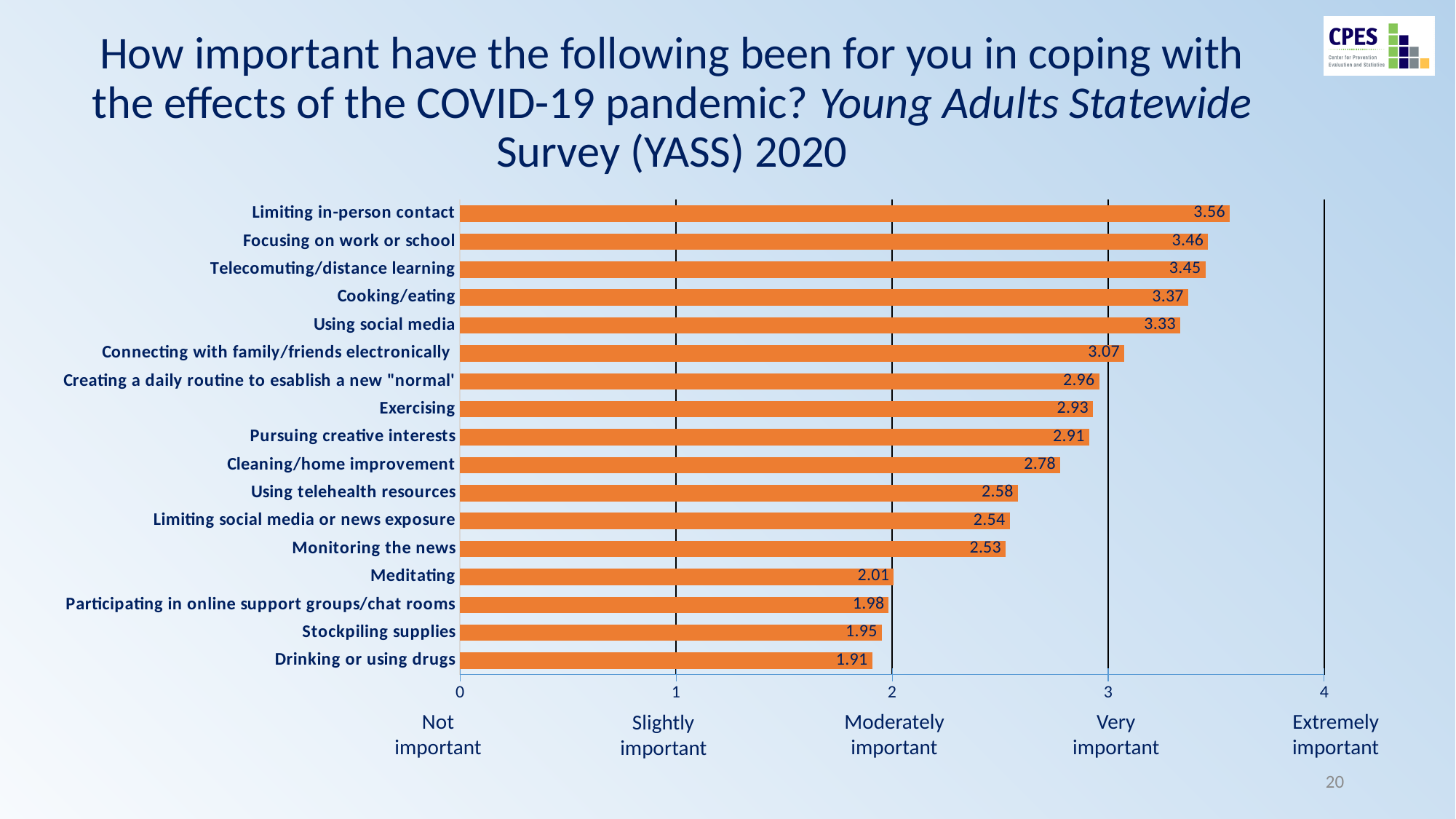
How many categories are shown in the chart? 17 What kind of chart is shown on the slide? bar chart What is the value for Meditating? 2.01 What is the difference between the values for Limiting in-person contact and Drinking or using drugs? 1.65 Is the value for Connecting with family/friends electronically greater or less than 3? greater What is the difference between the values for Cooking/eating and Exercising? 0.44 What is the value for Using telehealth resources? 2.58 Which category has the highest value? Limiting in-person contact Which is larger, the value for Using social media or the value for Cleaning/home improvement? Using social media What is the value for Limiting in-person contact? 3.56 Which category has the lowest value? Drinking or using drugs What label is shown under the value 4 on the x axis? Extremely important